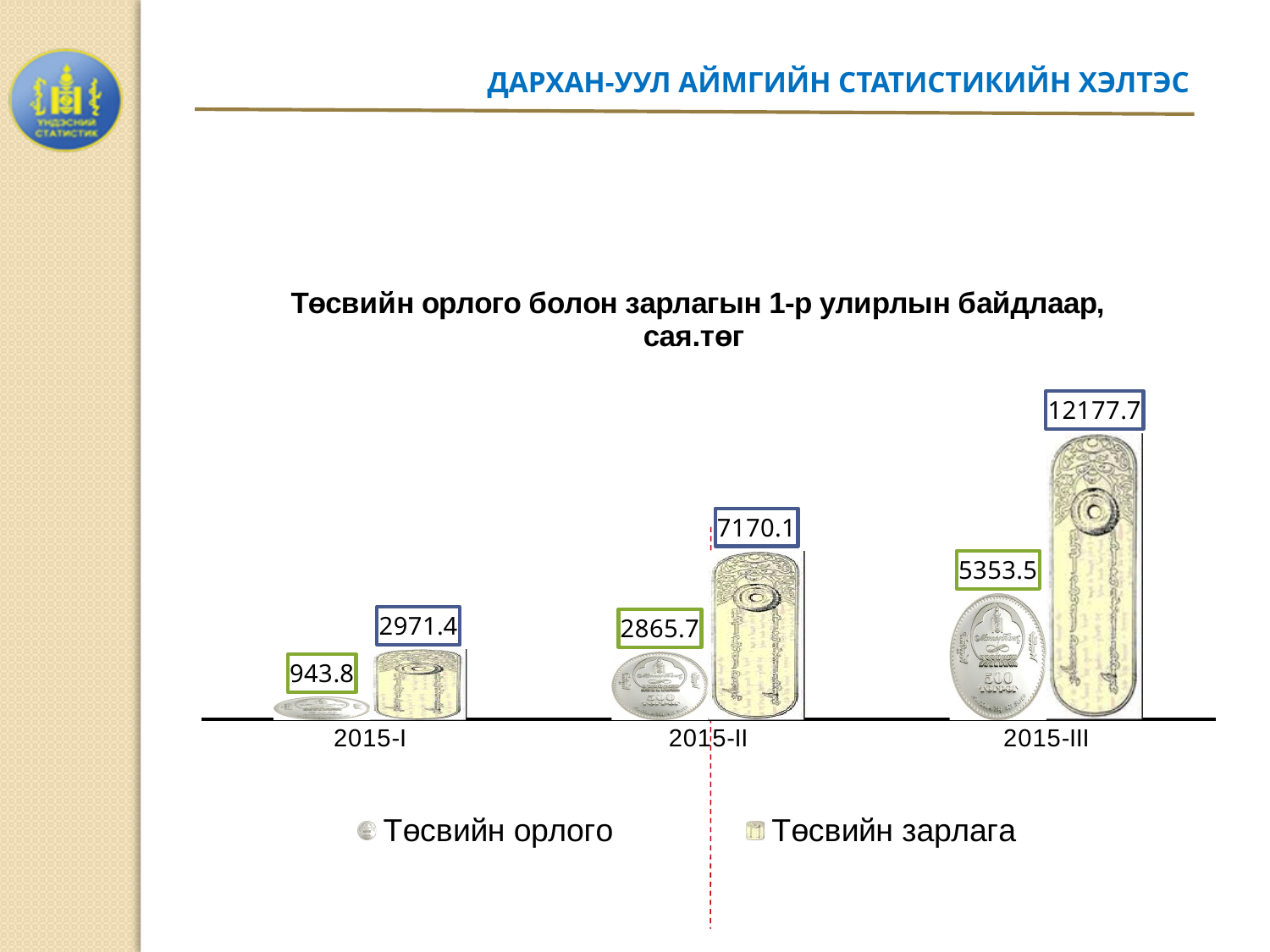
What is the value of Төсвийн зарлага for 2015-I? 2971.4 What is the difference between Төсвийн зарлага and Төсвийн орлого in 2015-I? 2027.6 Does Төсвийн орлого rise or fall from 2015-I to 2015-III? rise What is the value of Төсвийн зарлага for 2015-II? 7170.1 What is the difference between Төсвийн зарлага and Төсвийн орлого in 2015-III? 6824.2 Which period has the highest value of Төсвийн зарлага? 2015-III How many periods are shown on the x axis? 3 Which is larger in 2015-II: Төсвийн орлого or Төсвийн зарлага? Төсвийн зарлага What is the value of Төсвийн орлого for 2015-III? 5353.5 Which period has the lowest value of Төсвийн орлого? 2015-I What is the value of Төсвийн орлого for 2015-I? 943.8 How many series does the legend list? 2